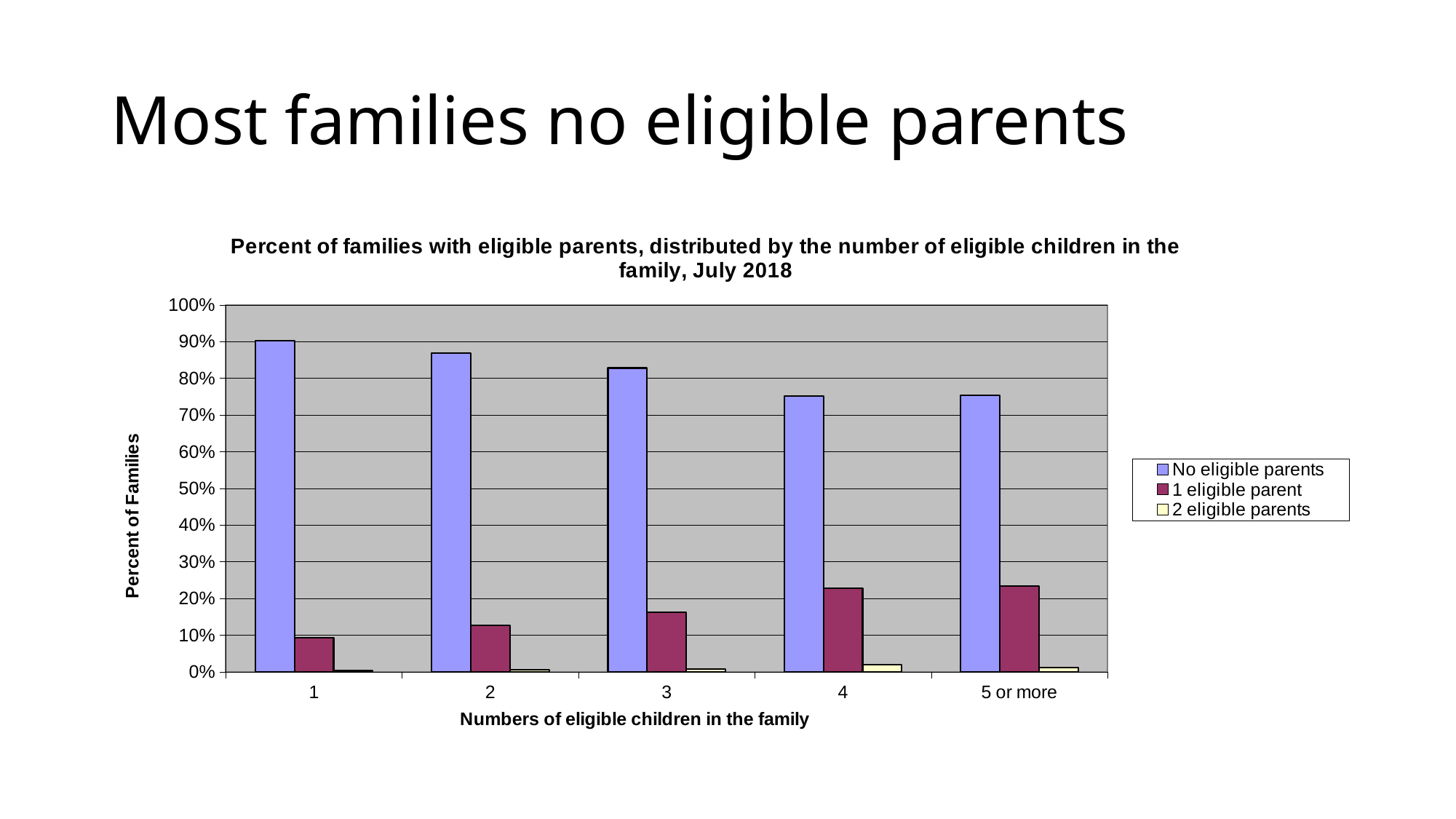
How many categories are shown on the x axis? 5 For families with 3 eligible children, which is larger: 'No eligible parents' or '1 eligible parent'? No eligible parents Is the value for 'No eligible parents' at 4 eligible children greater or less than 80%? less How many series does the legend list? 3 What kind of chart is shown on the slide? bar chart Which category has the highest value for 'No eligible parents'? 1 Is the value for '1 eligible parent' at 4 eligible children greater or less than 20%? greater Is the value for 'No eligible parents' at 1 eligible child greater or less than 80%? greater Do the values for 'No eligible parents' rise or fall as the number of eligible children increases? fall What is the label of the y axis? Percent of Families Which category has the lowest value for '1 eligible parent'? 1